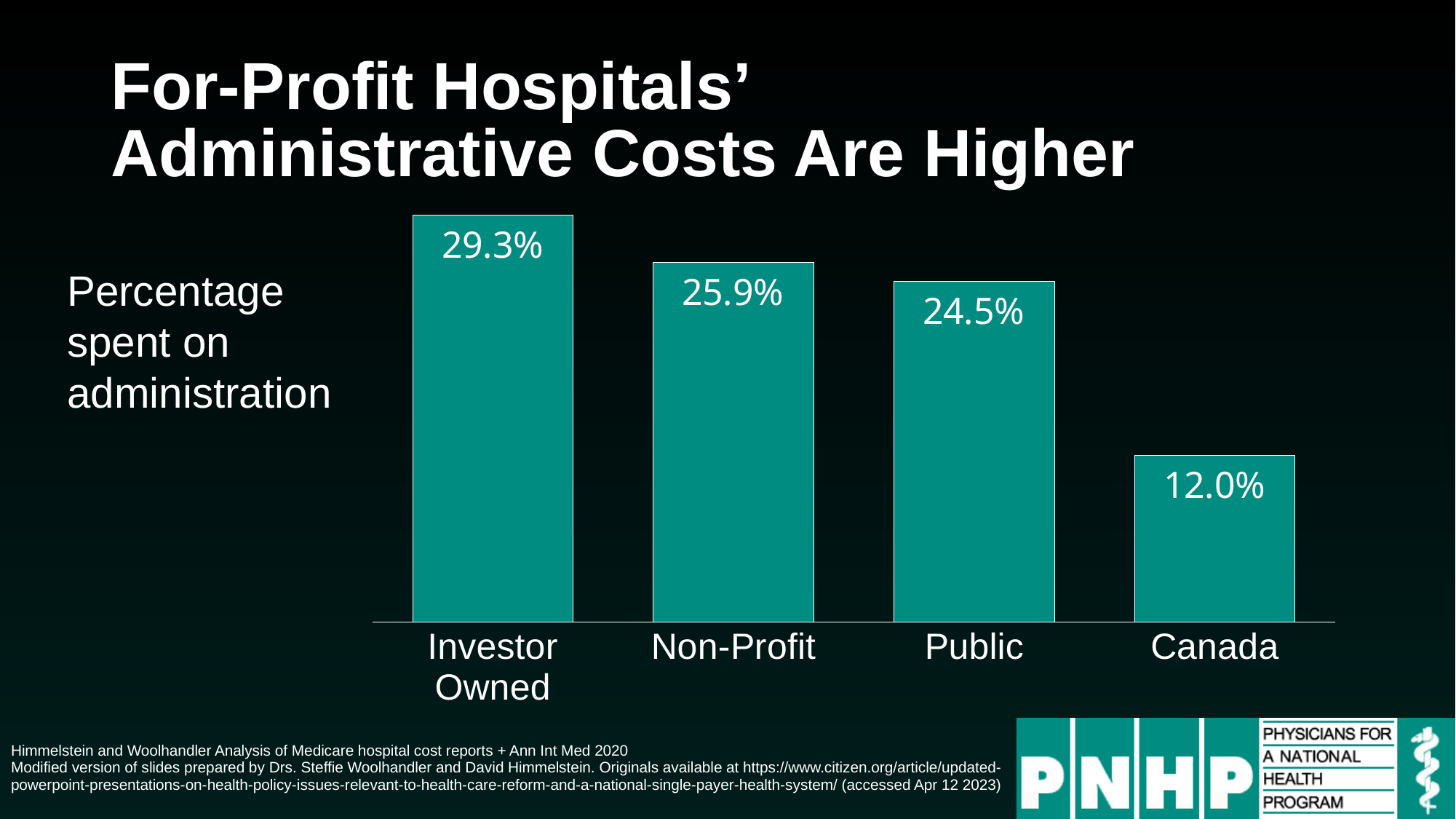
What percentage is spent on administration by Investor Owned hospitals? 29.3% What is the difference in percentage points between Investor Owned and Canada? 17.3 What percentage is spent on administration by Public hospitals? 24.5% What percentage is spent on administration in Canada? 12.0% Which category has the lowest percentage spent on administration? Canada What percentage is spent on administration by Non-Profit hospitals? 25.9% What kind of chart is shown on the slide? Bar chart How many categories are shown in the chart? 4 Do the values rise or fall from left to right across the categories? Fall What is the difference in percentage points between Non-Profit and Public hospitals? 1.4 Which category has the highest percentage spent on administration? Investor Owned Which has a higher percentage spent on administration, Public hospitals or Canada? Public